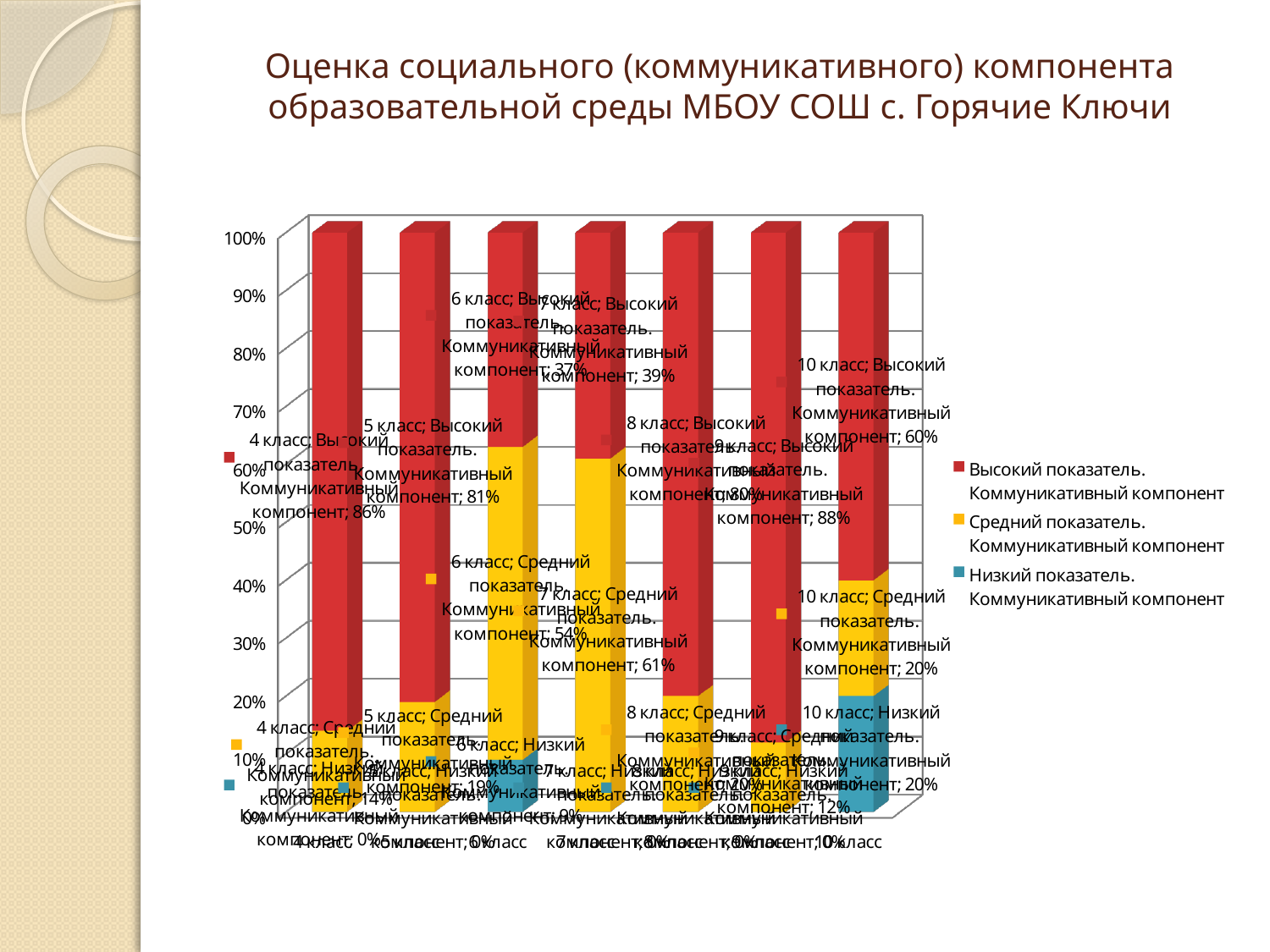
What kind of chart is shown on the slide? Stacked bar chart Which is larger: the 'Средний показатель' value for 6 класс or for 10 класс? 6 класс Which series is shown in red in the legend? Высокий показатель. Коммуникативный компонент What is the value of 'Высокий показатель. Коммуникативный компонент' for 9 класс? 88% What is the value of 'Низкий показатель. Коммуникативный компонент' for 10 класс? 20% What is the value of 'Средний показатель. Коммуникативный компонент' for 7 класс? 61% How many classes (categories) are plotted along the x axis? 7 How many series does the legend list? 3 What is the value of 'Высокий показатель. Коммуникативный компонент' for 6 класс? 37% Which class has the lowest value for 'Высокий показатель. Коммуникативный компонент'? 6 класс What is the difference between the 'Высокий показатель' values for 4 класс (86%) and 5 класс (81%)? 5 percentage points Which class has the highest value for 'Высокий показатель. Коммуникативный компонент'? 9 класс